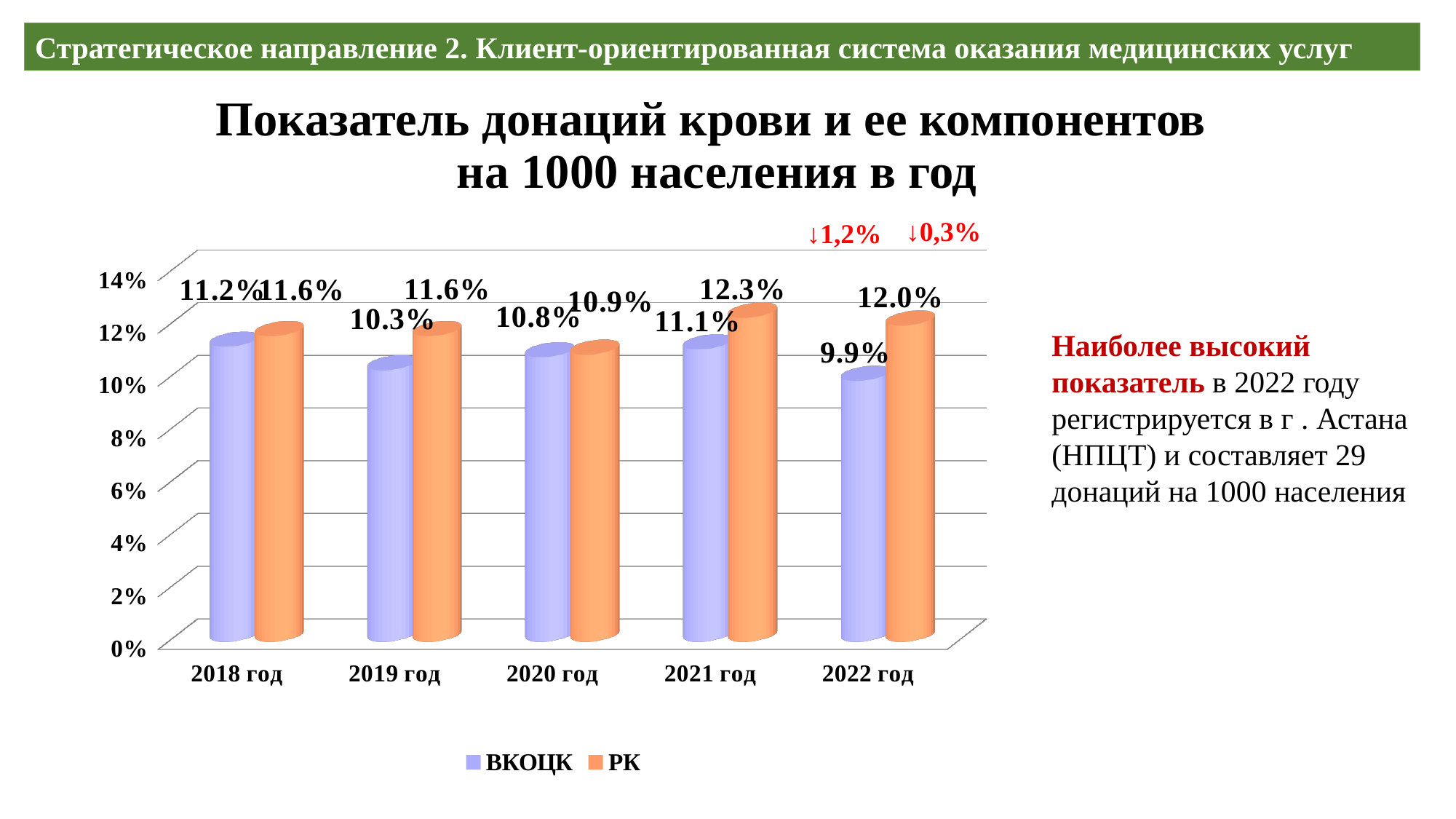
What is the value for РК in 2021 год? 12.3% What is the value for РК in 2020 год? 10.9% What is the value for ВКОЦК in 2018 год? 11.2% What is the value for ВКОЦК in 2022 год? 9.9% What kind of chart is shown on the slide? Bar chart In which year is the ВКОЦК value the lowest? 2022 год Which series is shown in orange in the legend? РК What is the difference between the РК and ВКОЦК values in 2022 год? 2.1% Which is larger in 2019 год, the ВКОЦК value or the РК value? РК How many years are shown on the x axis? 5 In which year is the РК value the highest? 2021 год How many series does the legend list? 2